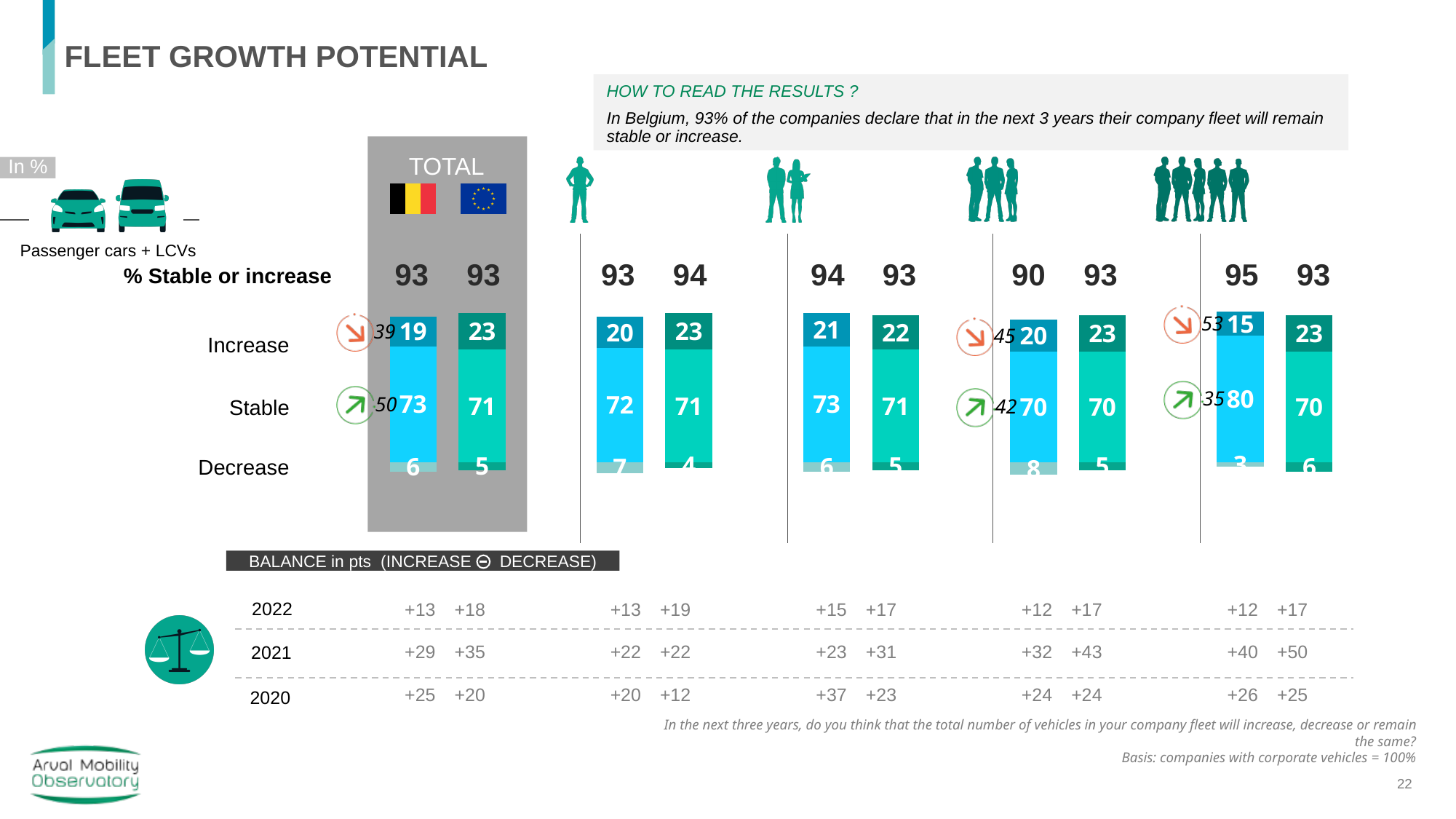
In the TOTAL block, what is the Stable value for the EU bar? 71 What is the '% Stable or increase' figure for Belgium in the TOTAL block? 93 In the TOTAL block, which bar has the larger Stable value, Belgium or EU? Belgium How many segments (categories) make up each stacked bar? 3 In the BALANCE table, what is the 2022 balance for Belgium in the TOTAL column? +13 What kind of chart is used to show the Increase, Stable and Decrease shares on this slide? Stacked bar chart In the TOTAL block, what is the Increase value for the Belgium bar? 19 In the TOTAL block, what is the Decrease value for the Belgium bar? 6 In the rightmost group of bars on the slide, what is the Decrease value for the Belgium bar? 3 In the BALANCE table, what is the 2021 balance for the EU in the TOTAL column? +35 In the TOTAL block, what is the difference between the EU Increase value and the Belgium Increase value? 4 What is the heading printed at the top of the grey shaded block? TOTAL